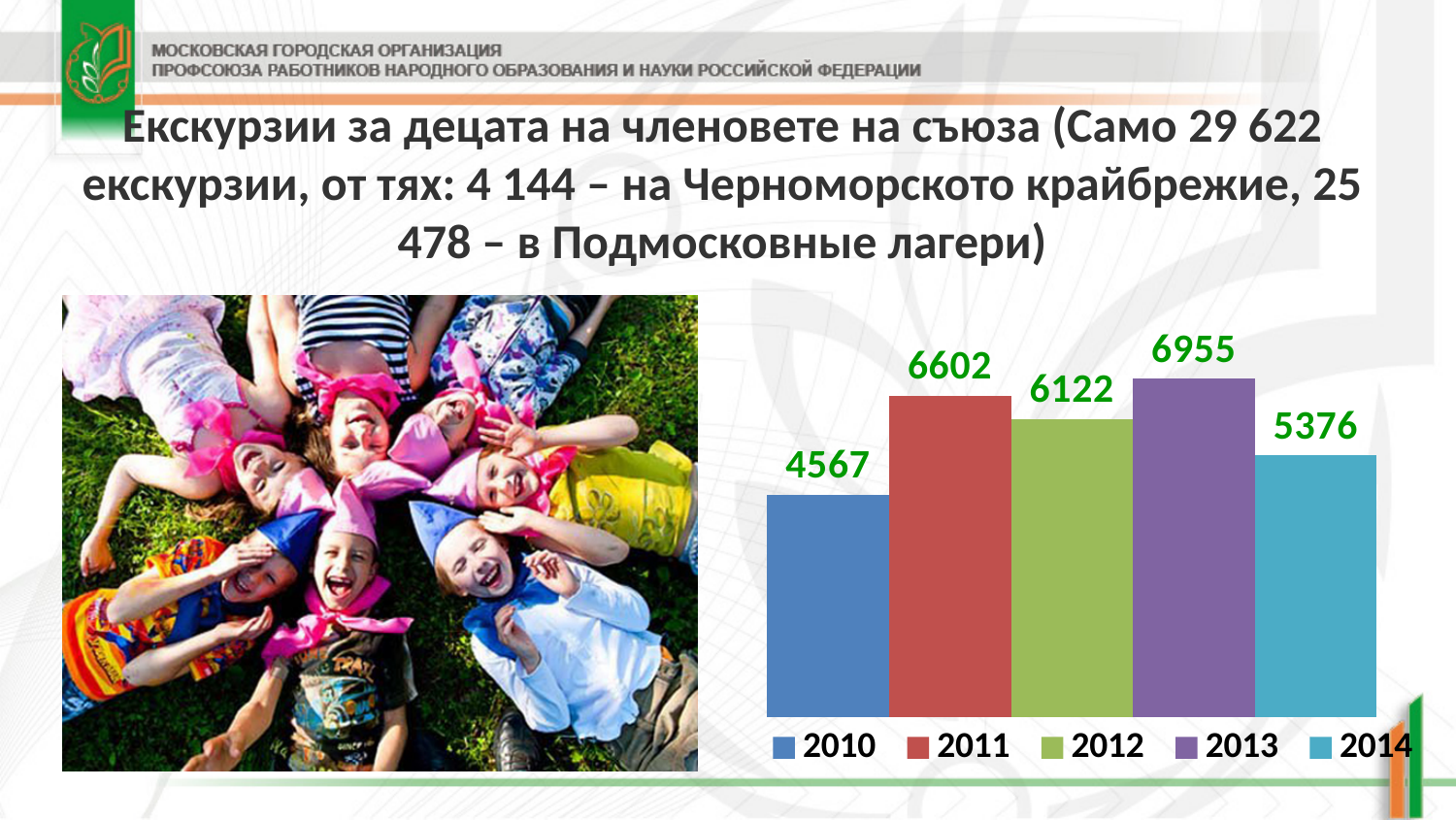
What is the value for 2010? 4567 Which year has the lowest value? 2010 What is the difference between the values for 2013 and 2010? 2388 How many years are shown in the chart? 5 What is the value for 2014? 5376 Which year has the highest value? 2013 Which is larger, the value for 2011 or the value for 2014? 2011 What is the value for 2013? 6955 What colour is the bar for 2012? green What is the difference between the values for 2011 and 2012? 480 How many entries does the legend list? 5 What kind of chart is shown on the slide? bar chart